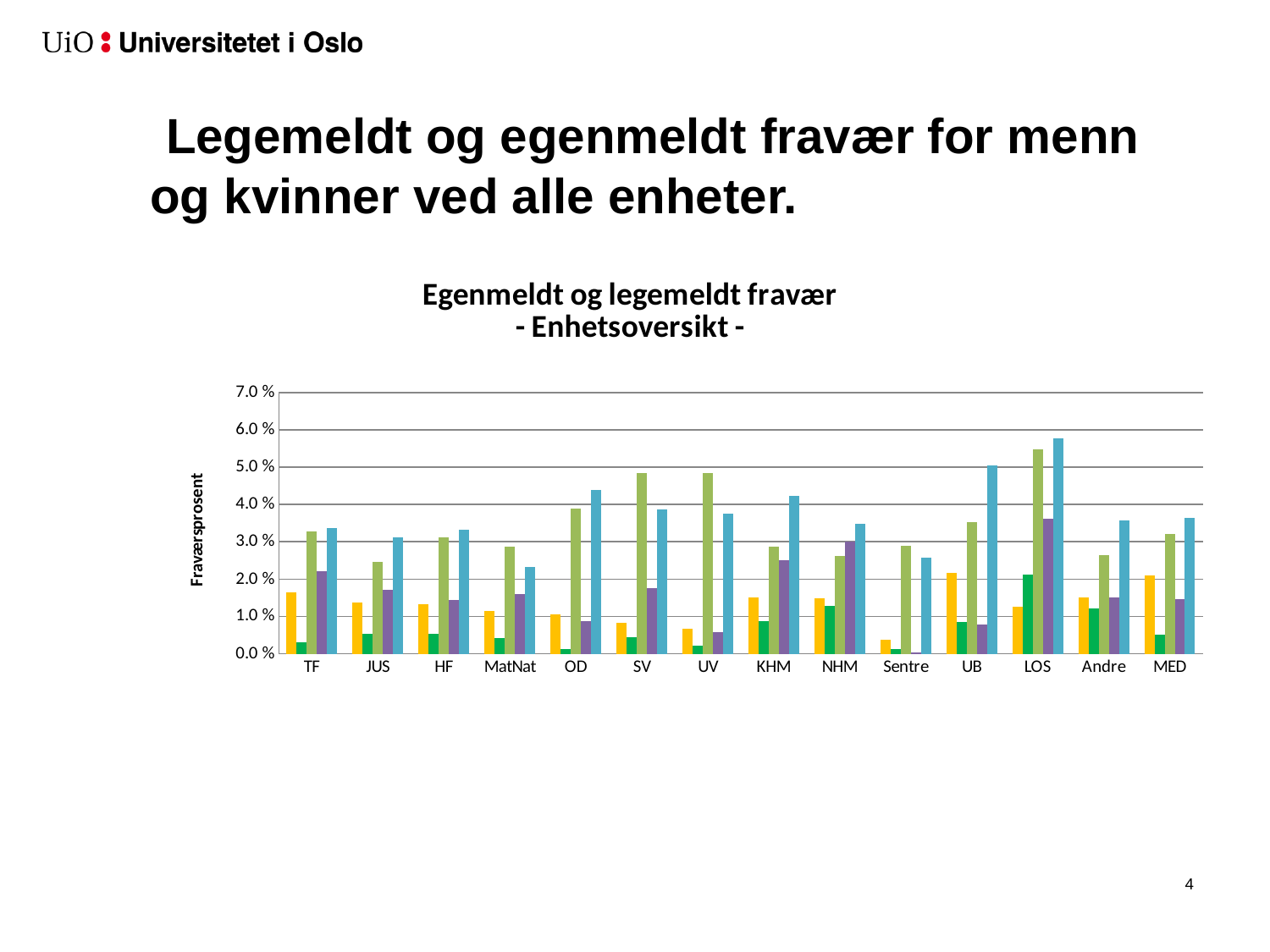
Which unit has the tallest light green bar in the chart? LOS How many bars are plotted for each unit in the chart? 5 Is the blue bar for LOS greater or less than 5.0 %? greater Which is larger: the blue bar for OD or the blue bar for SV? OD Is the blue bar for Sentre greater or less than 3.0 %? less Is the light green bar for UV greater or less than 4.0 %? greater What kind of chart is shown on the slide? bar chart Which unit has the tallest blue bar in the chart? LOS What is the label on the vertical axis of the chart? Fraværsprosent What is the title of the chart? Egenmeldt og legemeldt fravær - Enhetsoversikt - How many units (categories) are shown along the x axis of the chart? 14